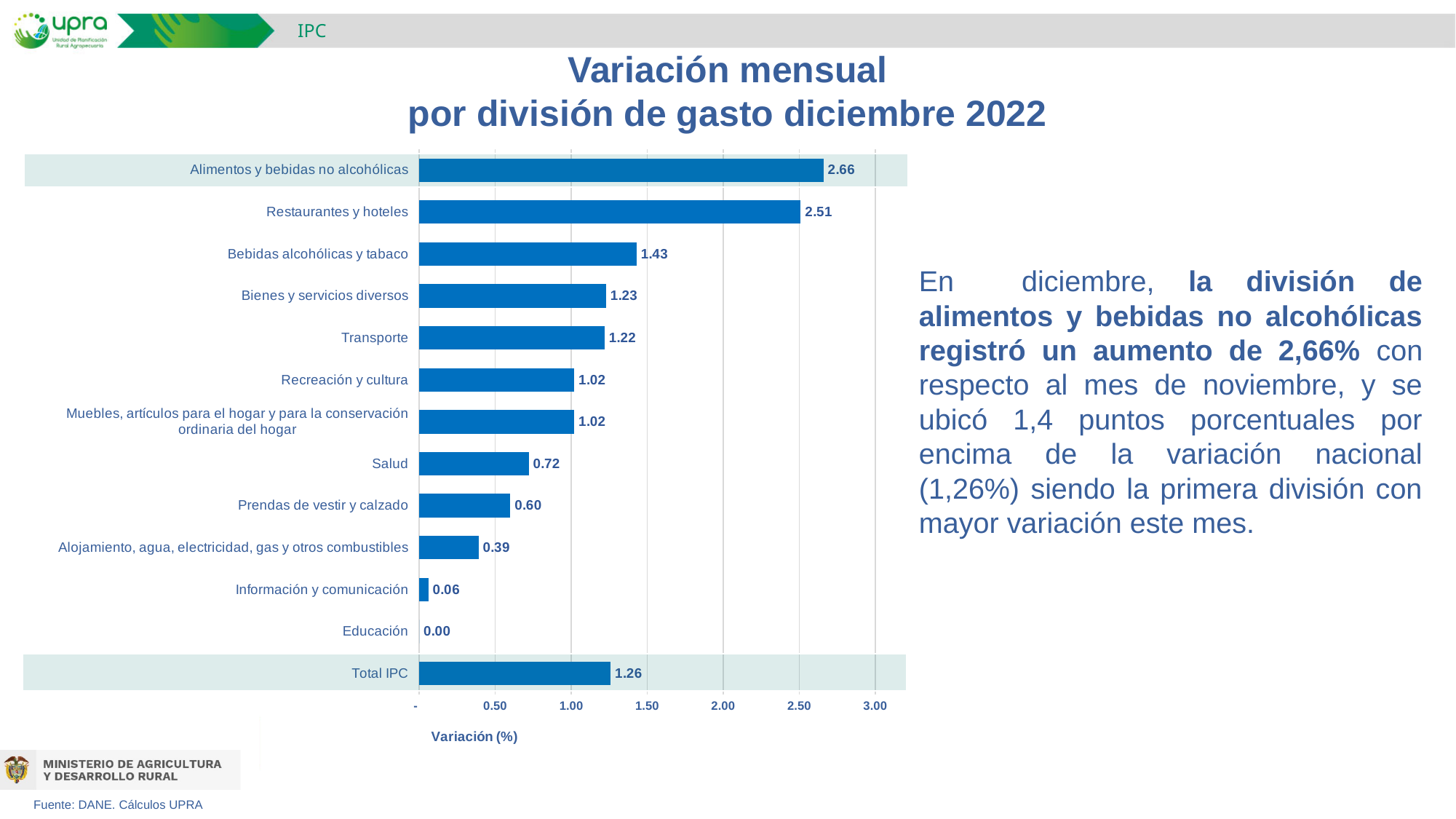
Which is larger, the value for Salud or the value for Prendas de vestir y calzado? Salud What is the value for Restaurantes y hoteles? 2.51 What is the label of the horizontal axis? Variación (%) What is the value for Alojamiento, agua, electricidad, gas y otros combustibles? 0.39 Which category has the highest value? Alimentos y bebidas no alcohólicas What is the value for Transporte? 1.22 What is the difference between the values for Alimentos y bebidas no alcohólicas and Restaurantes y hoteles? 0.15 Is the value for Bebidas alcohólicas y tabaco greater or less than 1.00? greater What kind of chart is shown on the slide? Bar chart Which category has the lowest value? Educación How many categories are shown in the chart? 13 What is the value for Total IPC? 1.26